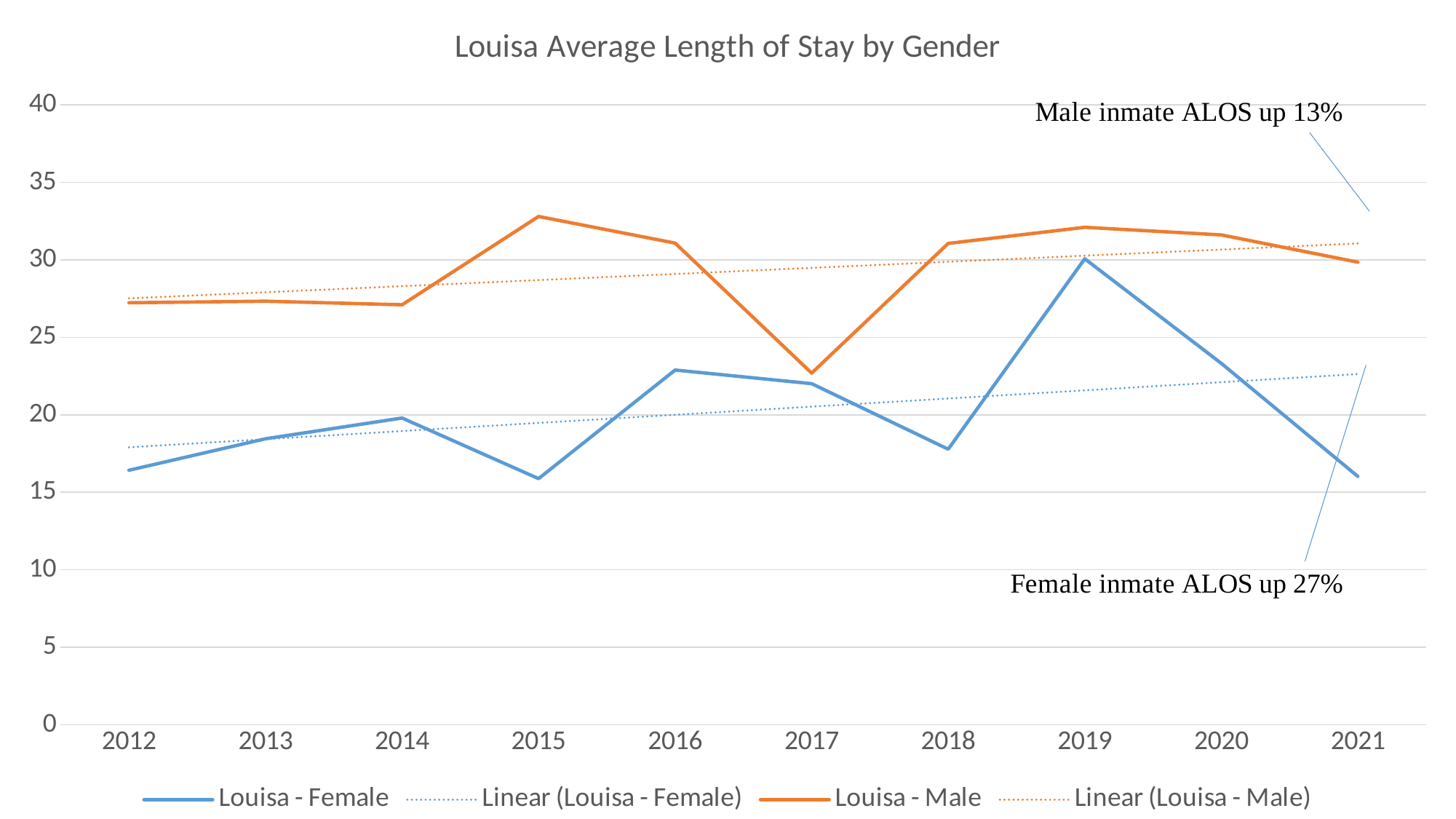
Is the Louisa - Male value for 2017 greater or less than 25? less In 2012, which is larger: the Louisa - Male value or the Louisa - Female value? Louisa - Male In which year is the Louisa - Male value lowest? 2017 Is the Louisa - Female value for 2012 greater or less than 20? less How many years are shown on the x axis? 10 How many entries does the legend list? 4 According to the annotation on the chart, by what percentage is female inmate ALOS up? 27% What is the title of the chart? Louisa Average Length of Stay by Gender In which year is the Louisa - Female value highest? 2019 Is the Louisa - Female value for 2019 greater or less than 25? greater What kind of chart is shown on the slide? line chart